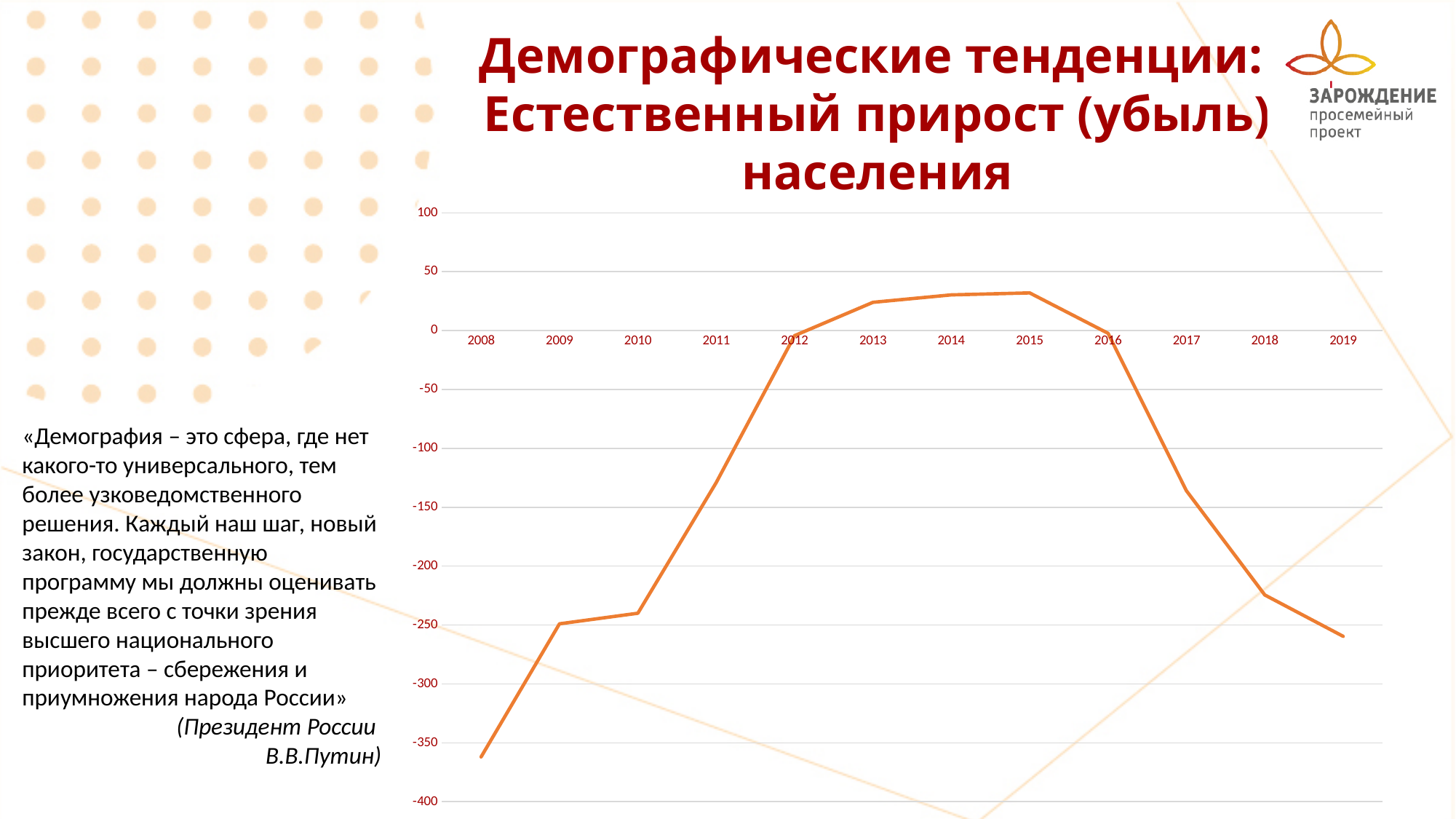
What kind of chart is shown on the slide? line chart Do the values rise or fall from 2008 to 2015? rise Which is larger, the value for 2008 or the value for 2019? 2019 Is the value for 2011 greater or less than -100? less Do the values rise or fall from 2015 to 2019? fall Is the value for 2009 greater or less than -300? greater How many years are plotted on the x axis of the chart? 12 Is the value for 2008 greater or less than -300? less Which is larger, the value for 2013 or the value for 2017? 2013 Which year has the lowest value on the chart? 2008